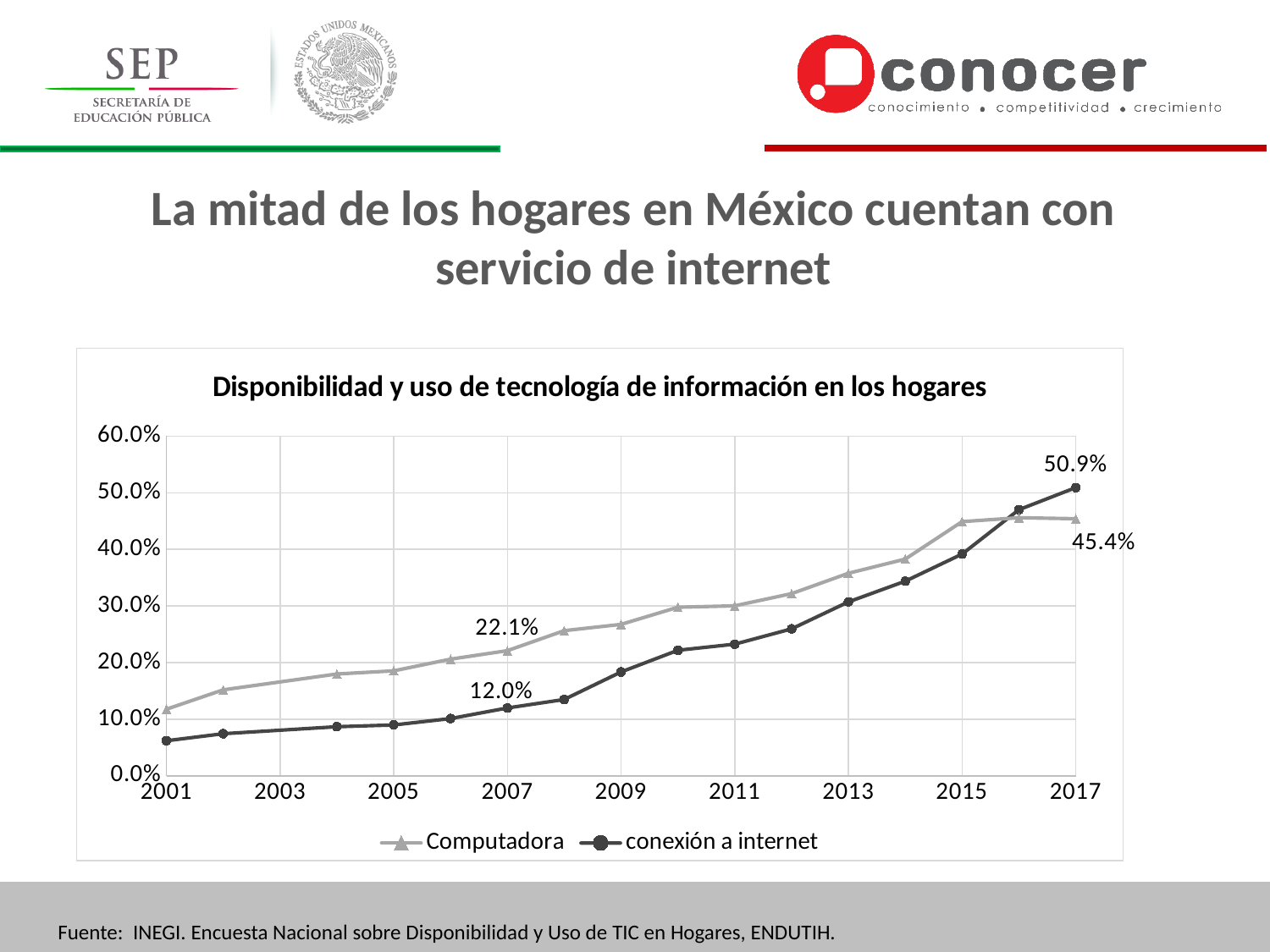
What is the difference between conexión a internet and Computadora in 2017? 5.5% What is the value for conexión a internet in 2017? 50.9% Is the value for conexión a internet in 2001 greater or less than 10.0%? less How many series does the legend list? 2 What is the value for Computadora in 2007? 22.1% What is the value for conexión a internet in 2007? 12.0% Do the values for conexión a internet rise or fall from 2001 to 2017? rise What is the value for Computadora in 2017? 45.4% What kind of chart is shown? line chart Is the value for Computadora in 2015 greater or less than 40.0%? greater In 2017, which series has the higher value, Computadora or conexión a internet? conexión a internet What is the difference between Computadora and conexión a internet in 2007? 10.1%